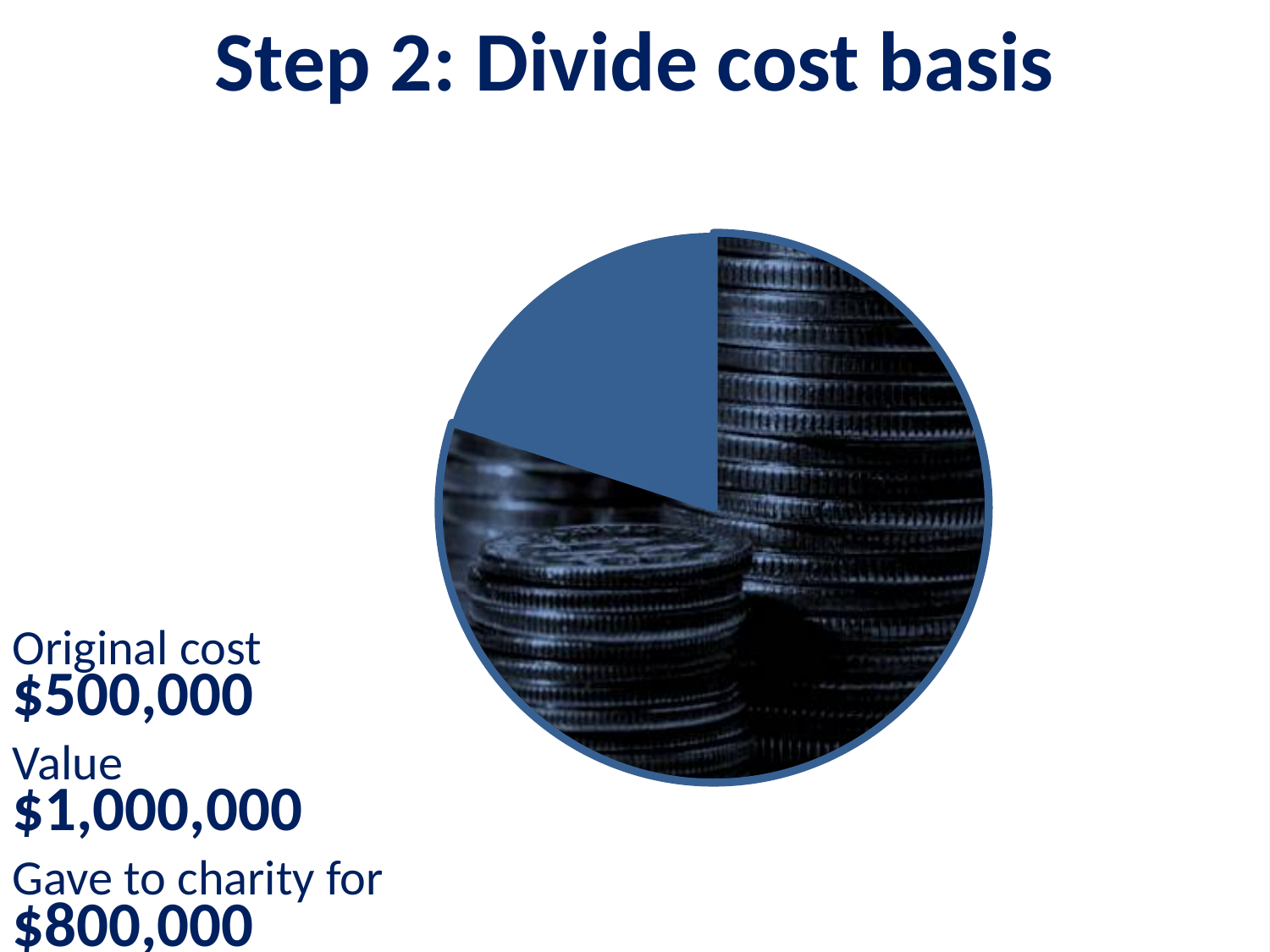
How many slices does the pie chart have? 2 Does the pie chart display a legend? No Is the solid blue slice more or less than half of the pie? less Is the coin-image slice more or less than half of the pie? more Which slice of the pie chart is larger, the solid blue slice or the slice filled with the coin image? the slice filled with the coin image Which slice of the pie chart is the smallest? the solid blue slice What kind of chart is shown on the slide? pie chart What is the title of the slide containing the pie chart? Step 2: Divide cost basis